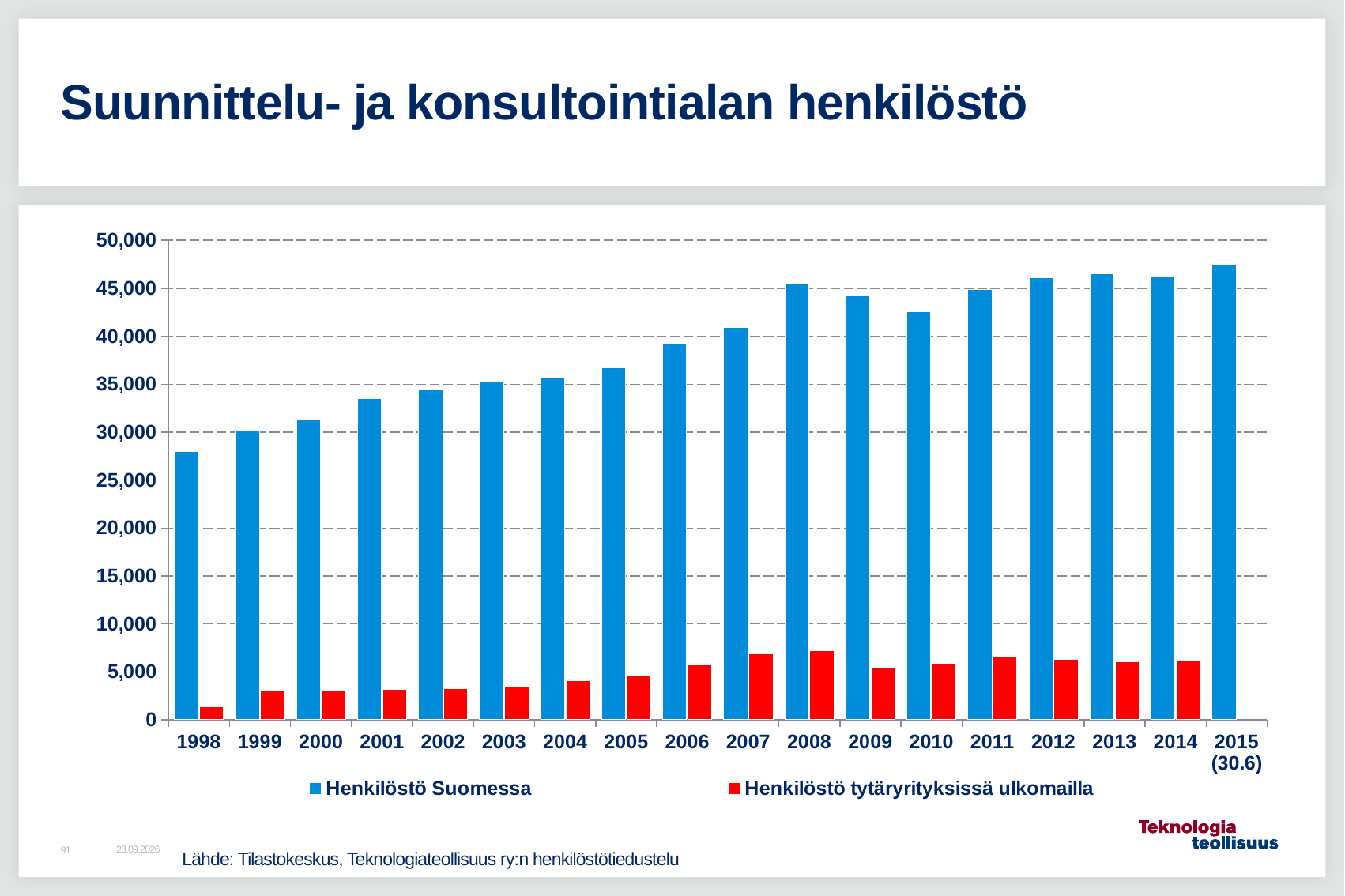
Is the value for Henkilöstö Suomessa in 1998 greater or less than 30,000? less How many years are shown on the x axis? 18 Which year has the highest value for Henkilöstö Suomessa? 2015 (30.6) Does the value for Henkilöstö Suomessa generally rise or fall from 1998 to 2015? rise What kind of chart is shown on the slide? bar chart Which colour represents Henkilöstö tytäryrityksissä ulkomailla in the chart? red Is the value for Henkilöstö Suomessa in 2010 greater or less than 40,000? greater How many series does the legend list? 2 Is the value for Henkilöstö tytäryrityksissä ulkomailla in 2008 greater or less than 5,000? greater Which is larger for Henkilöstö Suomessa, 2008 or 2010? 2008 Which year has the lowest value for Henkilöstö Suomessa? 1998 Which year has the highest value for Henkilöstö tytäryrityksissä ulkomailla? 2008